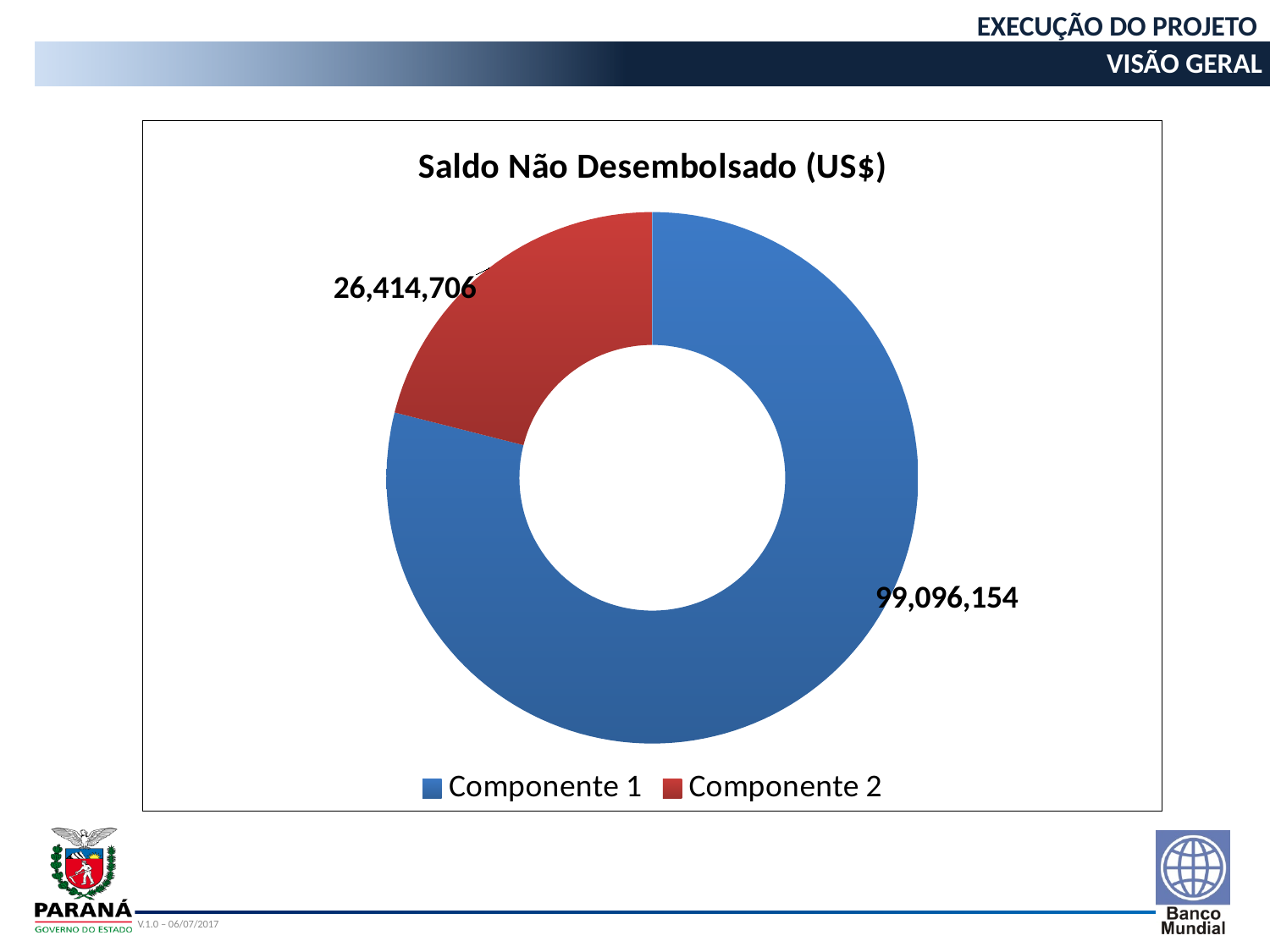
How many slices does the chart have? 2 What is the value for Componente 2 in the chart? 26,414,706 What is the total of the two values shown in the chart? 125,510,860 How many entries does the legend list? 2 What kind of chart is shown on the slide? Doughnut chart What is the title of the chart? Saldo Não Desembolsado (US$) Which component has the smallest unspent balance in the chart? Componente 2 What is the value for Componente 1 in the chart? 99,096,154 Which is larger, the value for Componente 1 or Componente 2? Componente 1 Which component has the largest unspent balance in the chart? Componente 1 What is the difference between the values for Componente 1 and Componente 2? 72,681,448